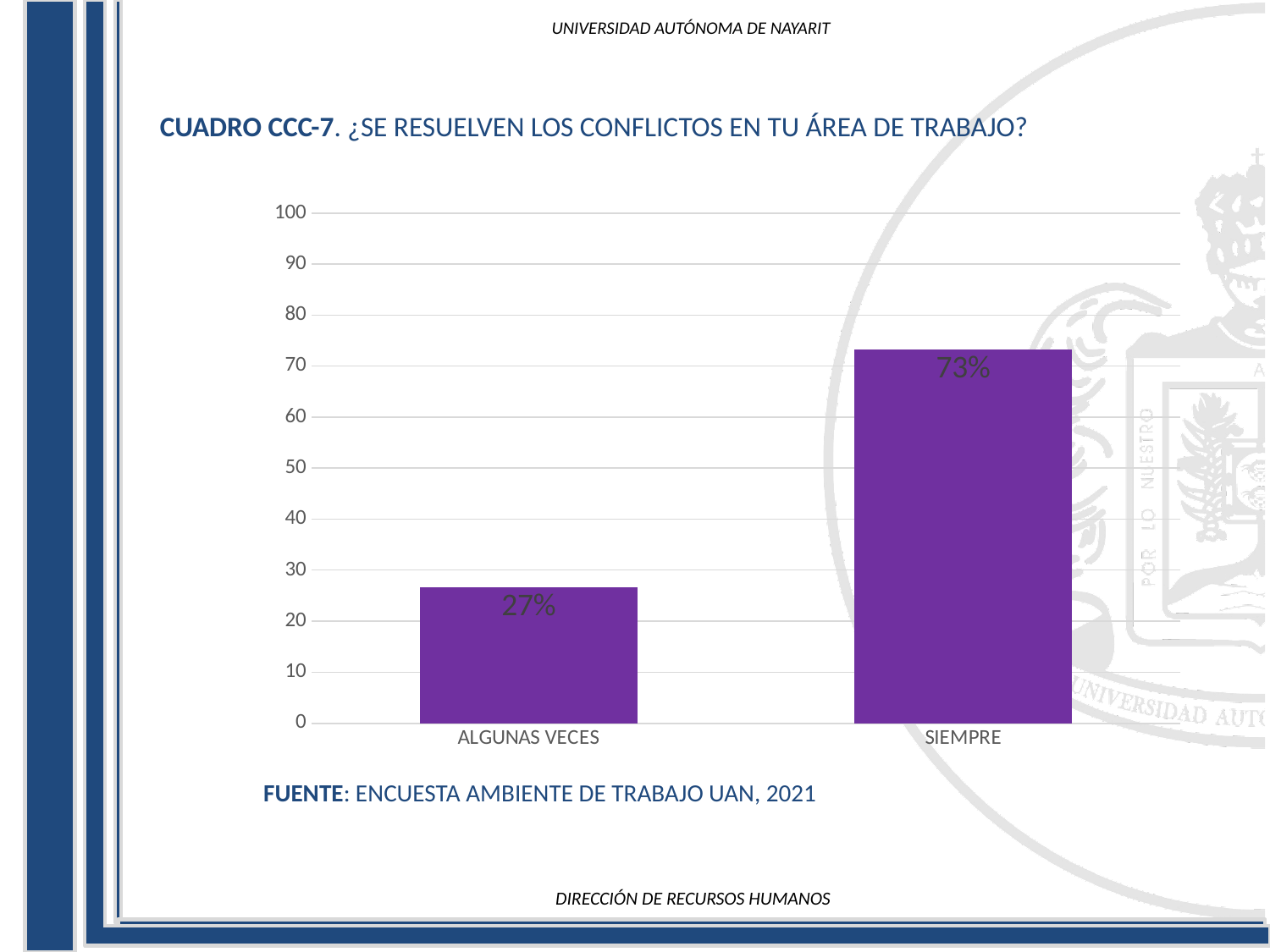
Which category has the highest value? SIEMPRE What is the title of the chart? CUADRO CCC-7. ¿SE RESUELVEN LOS CONFLICTOS EN TU ÁREA DE TRABAJO? Which is larger, the value for ALGUNAS VECES or the value for SIEMPRE? SIEMPRE Is the value for SIEMPRE greater or less than 50? greater What is the difference between the values for SIEMPRE and ALGUNAS VECES? 46% What is the value for SIEMPRE? 73% What is the value for ALGUNAS VECES? 27% Which category has the lowest value? ALGUNAS VECES What source is cited below the chart? ENCUESTA AMBIENTE DE TRABAJO UAN, 2021 Is the value for ALGUNAS VECES greater or less than 30? less How many categories are shown on the x axis? 2 What kind of chart is shown on the slide? bar chart